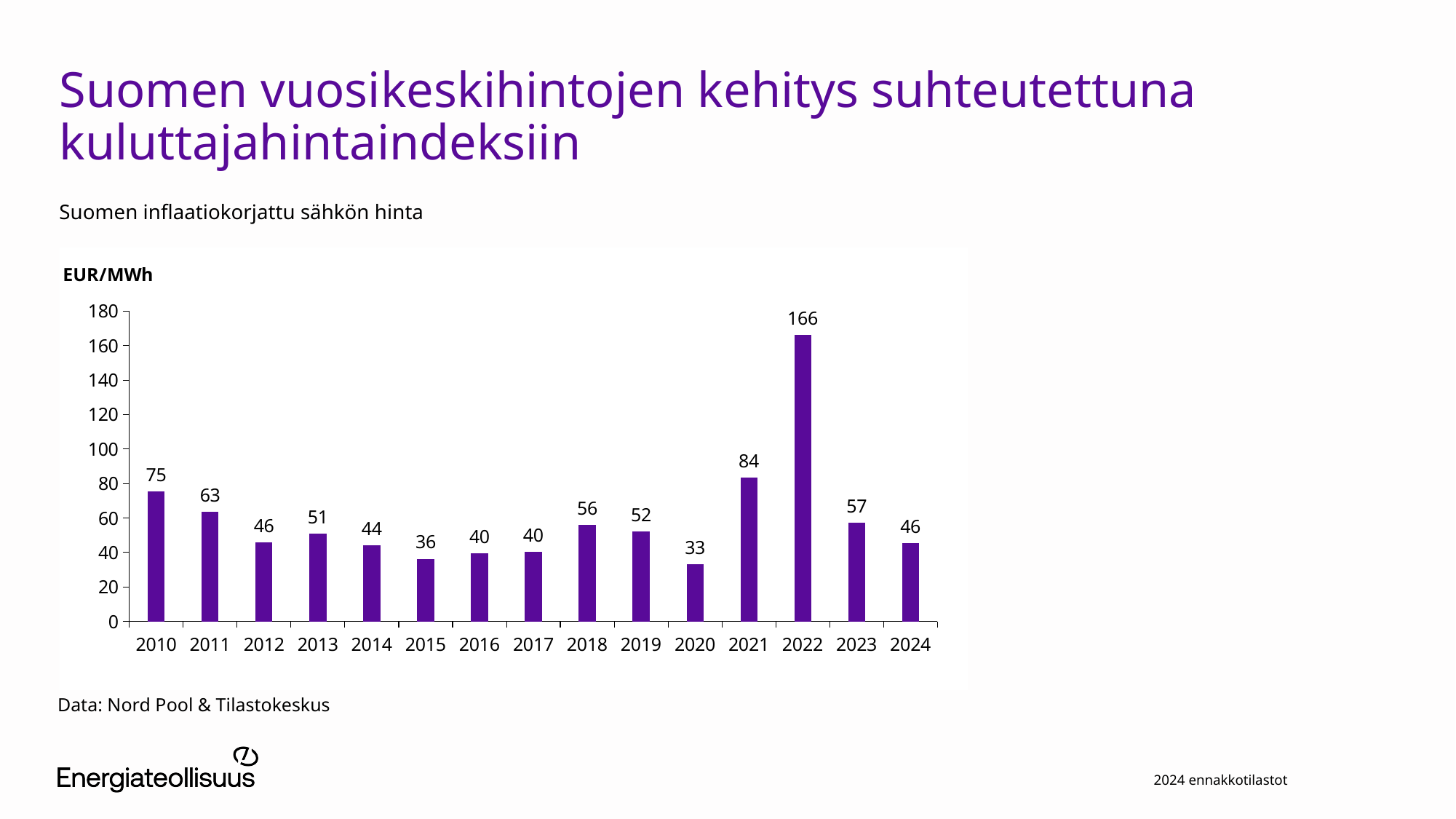
What is the inflation-adjusted electricity price for 2022? 166 What is the value shown for 2024? 46 What unit is shown on the y axis of the chart? EUR/MWh What kind of chart is shown on the slide? bar chart How many years are shown on the x axis? 15 Which year has the highest value? 2022 Is the value for 2021 greater or less than 100? less Which year has the lowest value? 2020 What is the difference between the values for 2023 and 2024? 11 What is the difference between the values for 2022 and 2021? 82 What is the value shown for 2010? 75 Which year has a higher value, 2011 or 2018? 2011